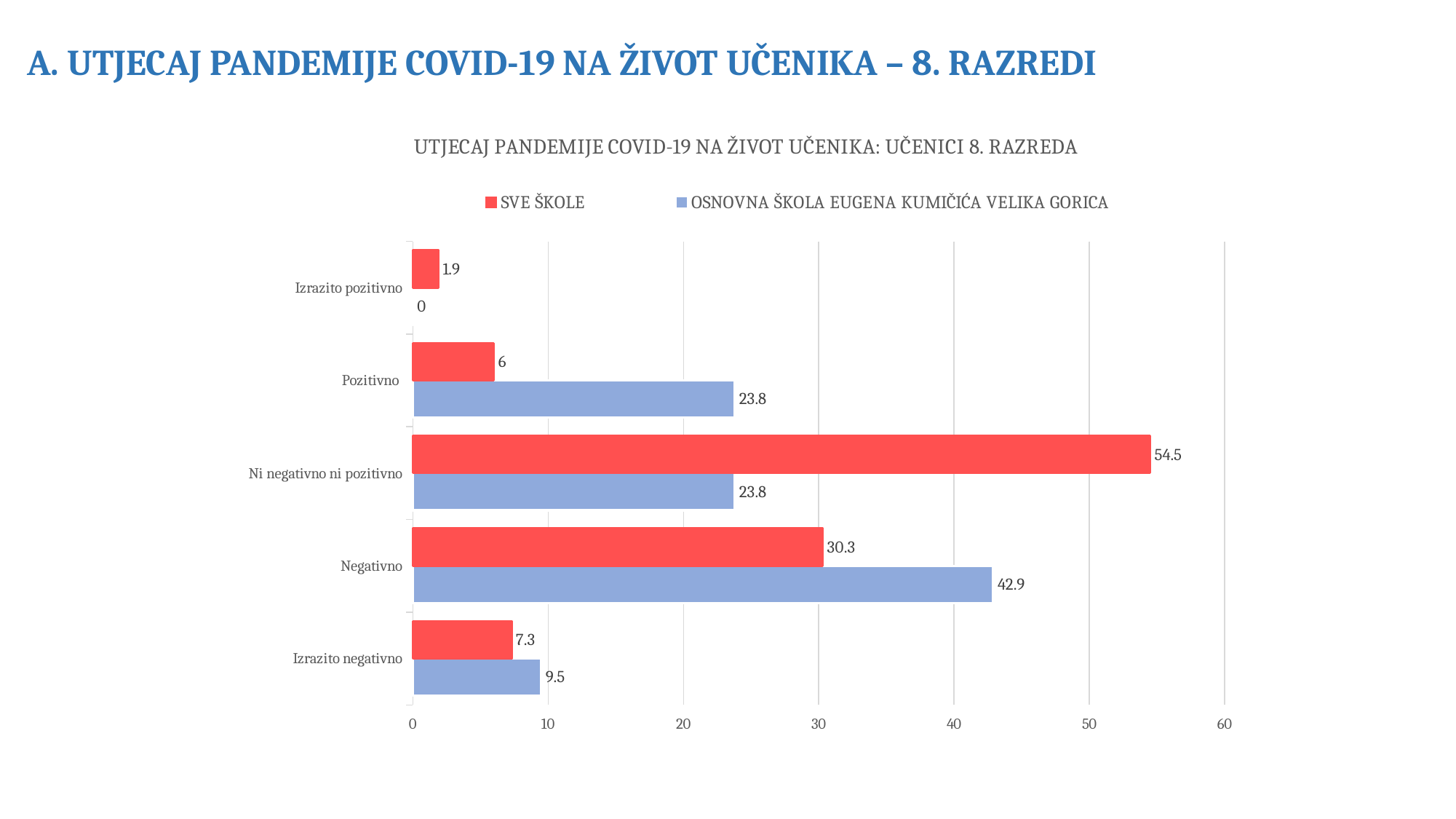
In the Pozitivno category, which series has the larger value? OSNOVNA ŠKOLA EUGENA KUMIČIĆA VELIKA GORICA What kind of chart is shown on the slide? Bar chart Which category has the highest value for SVE ŠKOLE? Ni negativno ni pozitivno How many categories are shown on the chart? 5 Is the value for SVE ŠKOLE in the Negativno category greater or less than 30? greater What is the difference between the SVE ŠKOLE and OSNOVNA ŠKOLA EUGENA KUMIČIĆA VELIKA GORICA values in the Negativno category? 12.6 Which category has the lowest value for SVE ŠKOLE? Izrazito pozitivno What is the value for OSNOVNA ŠKOLA EUGENA KUMIČIĆA VELIKA GORICA in the Izrazito pozitivno category? 0 What is the value for SVE ŠKOLE in the Ni negativno ni pozitivno category? 54.5 What is the value for OSNOVNA ŠKOLA EUGENA KUMIČIĆA VELIKA GORICA in the Negativno category? 42.9 What colour are the bars for the SVE ŠKOLE series? Red How many series does the legend list? 2